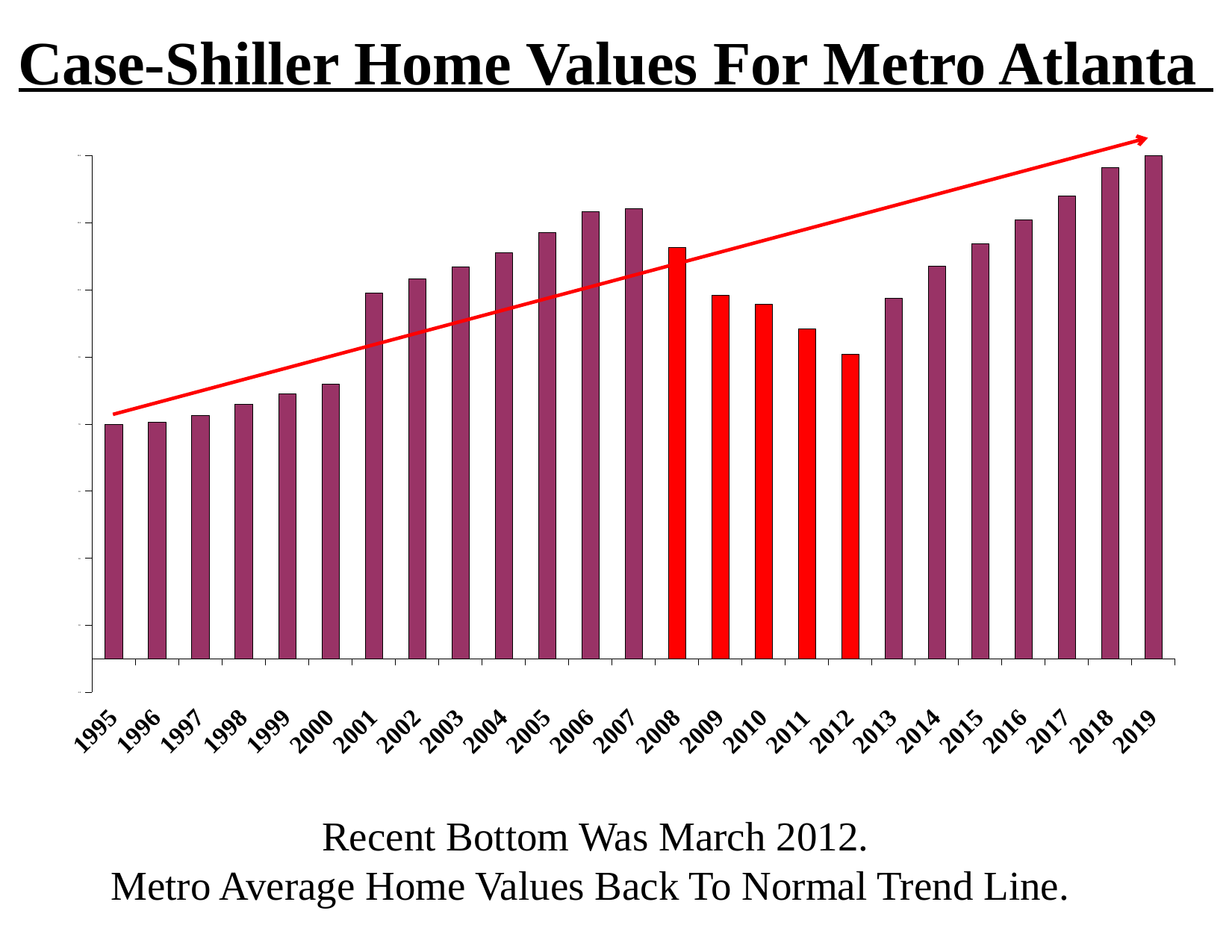
Which is larger, the value for 2000 or the value for 2001? 2001 Do the values rise or fall from 1995 to 2007? rise How many years are plotted along the x axis? 25 Which year has the highest bar? 2019 What kind of chart is shown on the slide? bar chart Among the red-highlighted bars, which year has the lowest value? 2012 Do the values rise or fall from 2007 to 2012? fall Do the values rise or fall from 2012 to 2019? rise Which is larger, the value for 2012 or the value for 2013? 2013 How many bars are highlighted in bright red? 5 Which is larger, the value for 2007 or the value for 2008? 2007 What is the title of the slide's chart? Case-Shiller Home Values For Metro Atlanta